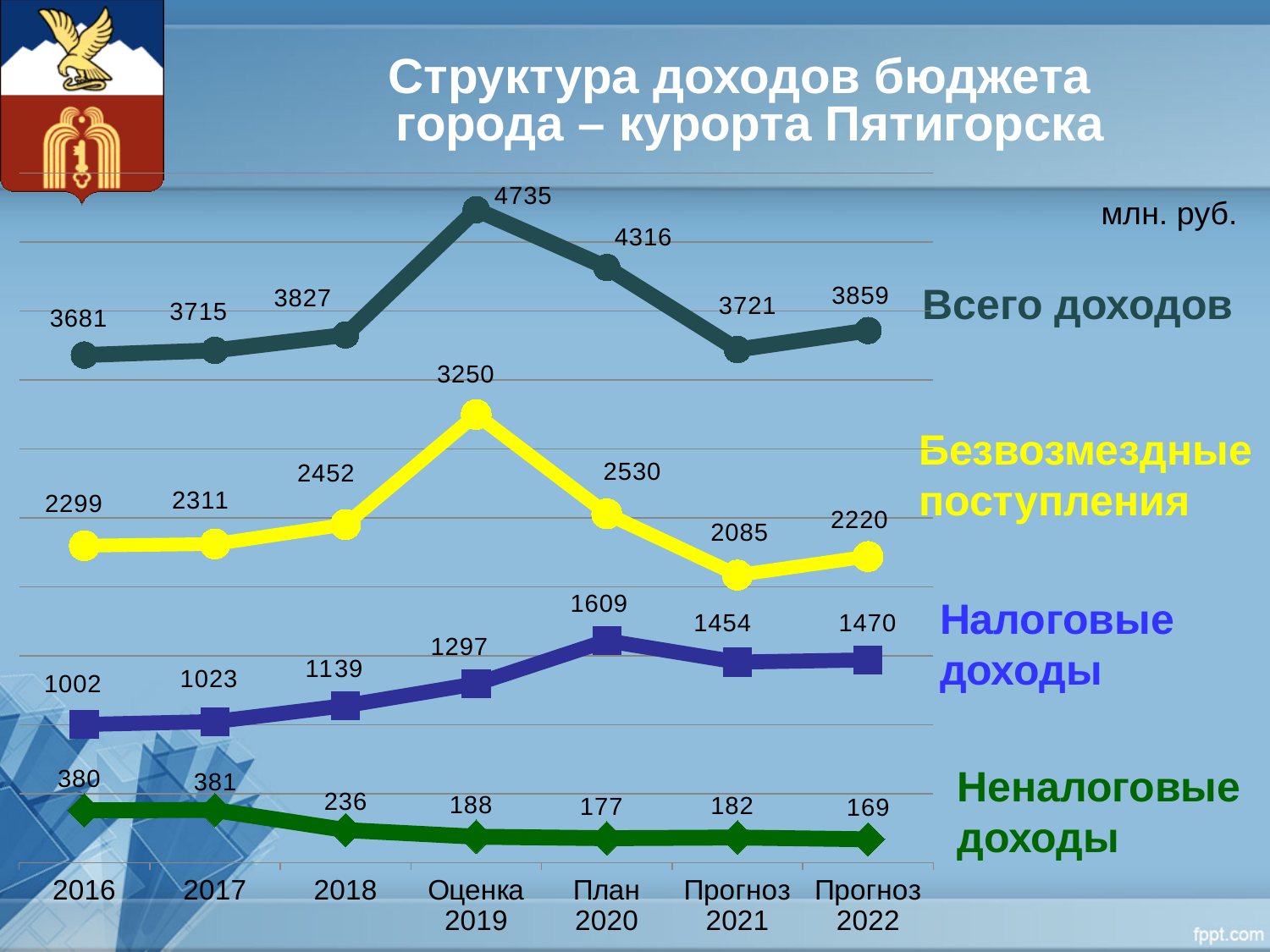
How many periods are shown on the x axis? 7 What is the value of Неналоговые доходы for 2017? 381 Which is larger: Налоговые доходы for Прогноз 2021 or for Прогноз 2022? Прогноз 2022 What is the value of Всего доходов for Оценка 2019? 4735 In which period is Всего доходов highest? Оценка 2019 What is the value of Налоговые доходы for План 2020? 1609 What is the difference between Всего доходов for Оценка 2019 and План 2020? 419 How many series are plotted on the chart? 4 What is the value of Безвозмездные поступления for Прогноз 2021? 2085 What type of chart is shown on the slide? line chart Do the values of Неналоговые доходы generally rise or fall from 2016 to Прогноз 2022? fall In which period is Неналоговые доходы lowest? Прогноз 2022